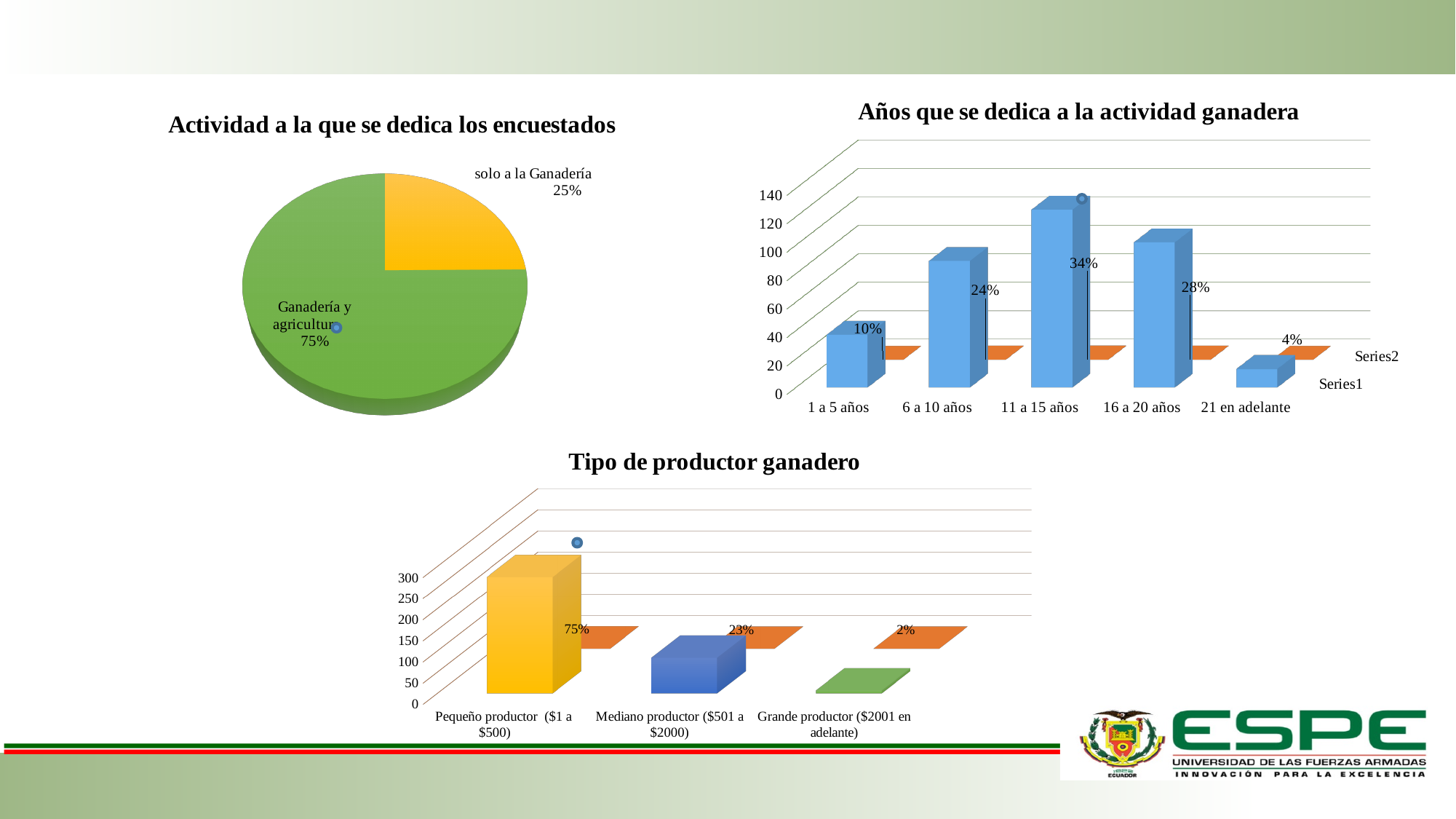
What kind of chart is 'Actividad a la que se dedica los encuestados'? Pie chart In the chart 'Tipo de productor ganadero', which category has the lowest value? Grande productor ($2001 en adelante) In the chart 'Tipo de productor ganadero', what percentage label is shown for 'Mediano productor ($501 a $2000)'? 23% In the chart 'Actividad a la que se dedica los encuestados', what share of respondents is labelled 'Ganadería y agricultura'? 75% In the chart 'Tipo de productor ganadero', is the bar for 'Pequeño productor ($1 a $500)' greater or less than 250? greater In the chart 'Años que se dedica a la actividad ganadera', what percentage label is shown for '11 a 15 años'? 34% In the chart 'Años que se dedica a la actividad ganadera', is the bar for '6 a 10 años' greater or less than 60? greater In the chart 'Años que se dedica a la actividad ganadera', what is the difference between the percentage labels for '16 a 20 años' and '6 a 10 años'? 4% In the chart 'Años que se dedica a la actividad ganadera', which category has the tallest bar? 11 a 15 años In the chart 'Años que se dedica a la actividad ganadera', what percentage label is shown for '21 en adelante'? 4% In the chart 'Años que se dedica a la actividad ganadera', how many categories are shown on the x axis? 5 In the chart 'Actividad a la que se dedica los encuestados', what share is labelled 'solo a la Ganadería'? 25%